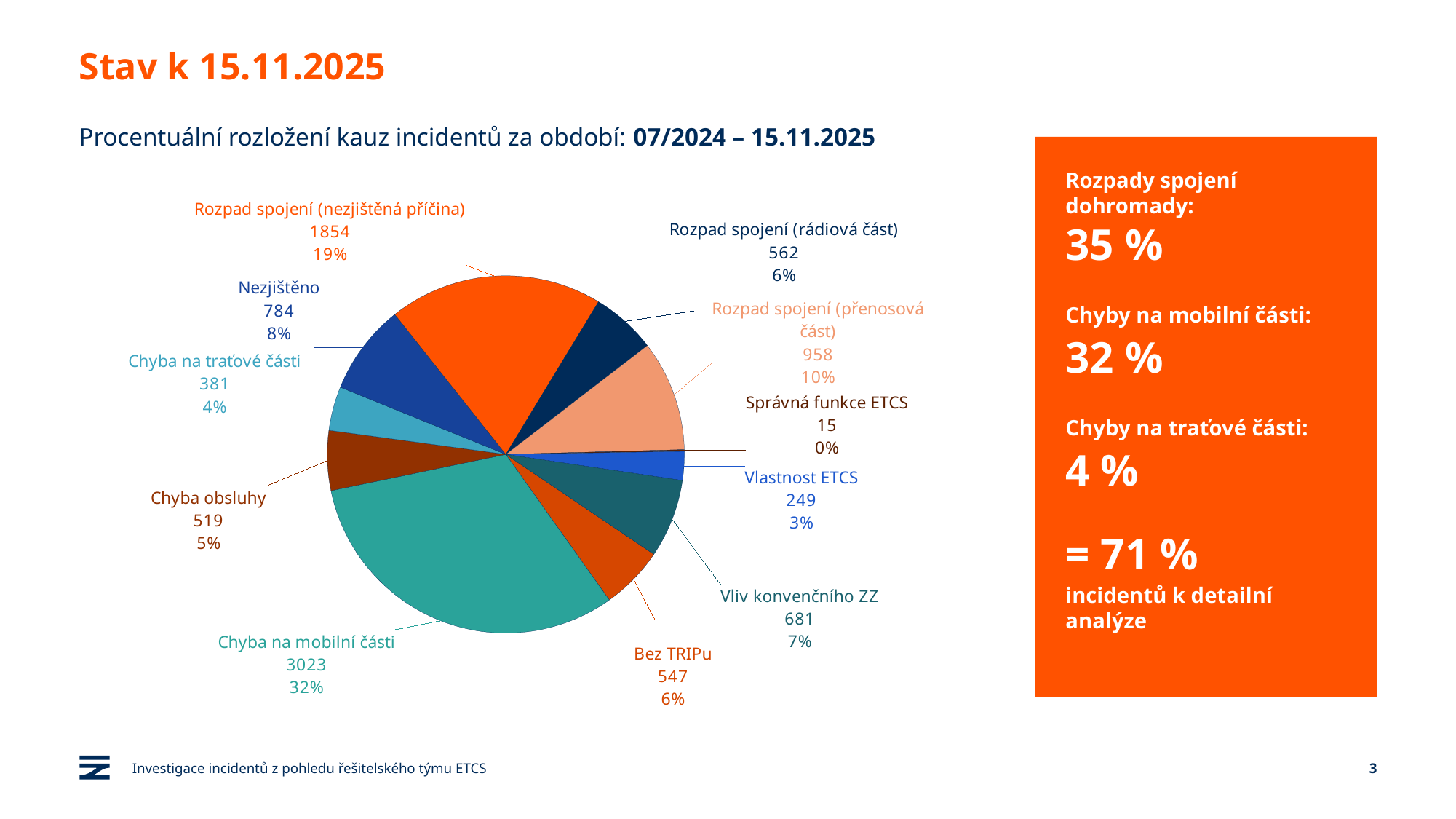
What percentage share is shown for "Vlastnost ETCS"? 3% What is the count shown for "Bez TRIPu"? 547 What is the count shown for "Chyba na mobilní části"? 3023 Which is larger, the value for "Nezjištěno" or the value for "Chyba obsluhy"? Nezjištěno How many categories (slices) does the pie chart have? 11 What is the value shown for "Vliv konvenčního ZZ"? 681 What period does the subtitle above the chart say the incident distribution covers? 07/2024 – 15.11.2025 Which category has the smallest slice in the pie chart? Správná funkce ETCS Which category has the largest slice in the pie chart? Chyba na mobilní části What percentage share does "Rozpad spojení (nezjištěná příčina)" have in the pie chart? 19% What kind of chart is shown on the slide? pie chart What is the difference between the counts for "Rozpad spojení (přenosová část)" and "Rozpad spojení (rádiová část)"? 396